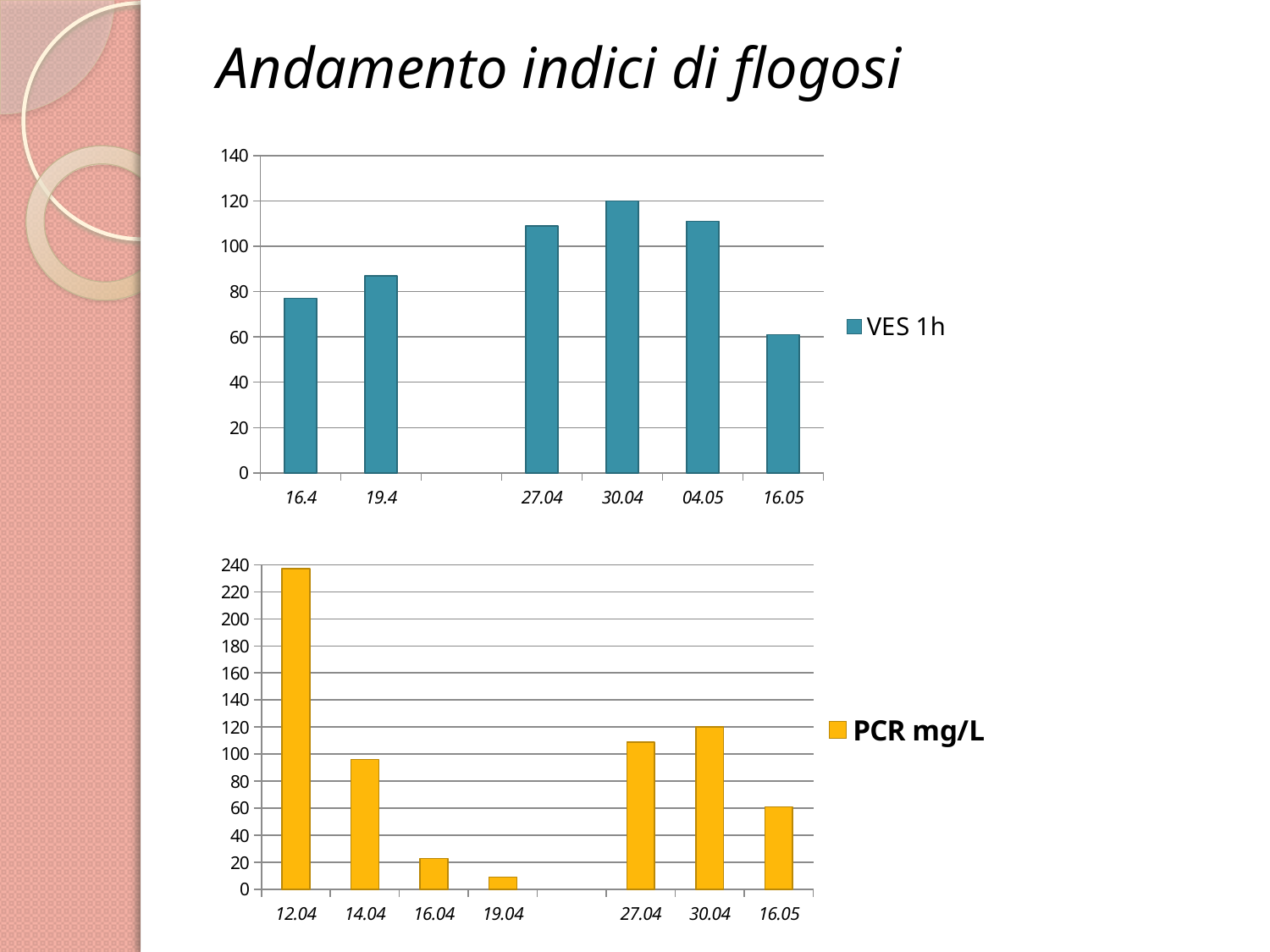
In the bottom chart (PCR mg/L), how many bars are plotted? 7 What is the legend entry of the bottom chart? PCR mg/L In the top chart (VES 1h), is the value for 16.4 greater or less than 80? less In the top chart (VES 1h), which category has the lowest bar? 16.05 In the bottom chart (PCR mg/L), do the values rise or fall from 12.04 to 19.04? fall In the top chart (VES 1h), which category has the highest bar? 30.04 In the top chart (VES 1h), how many bars are plotted? 6 In the bottom chart (PCR mg/L), which is larger, the value for 14.04 or the value for 16.04? 14.04 In the bottom chart (PCR mg/L), which category has the highest bar? 12.04 What kind of chart is the top chart with the VES 1h legend? bar chart In the bottom chart (PCR mg/L), which category has the lowest bar? 19.04 In the bottom chart (PCR mg/L), is the value for 12.04 greater or less than 220? greater